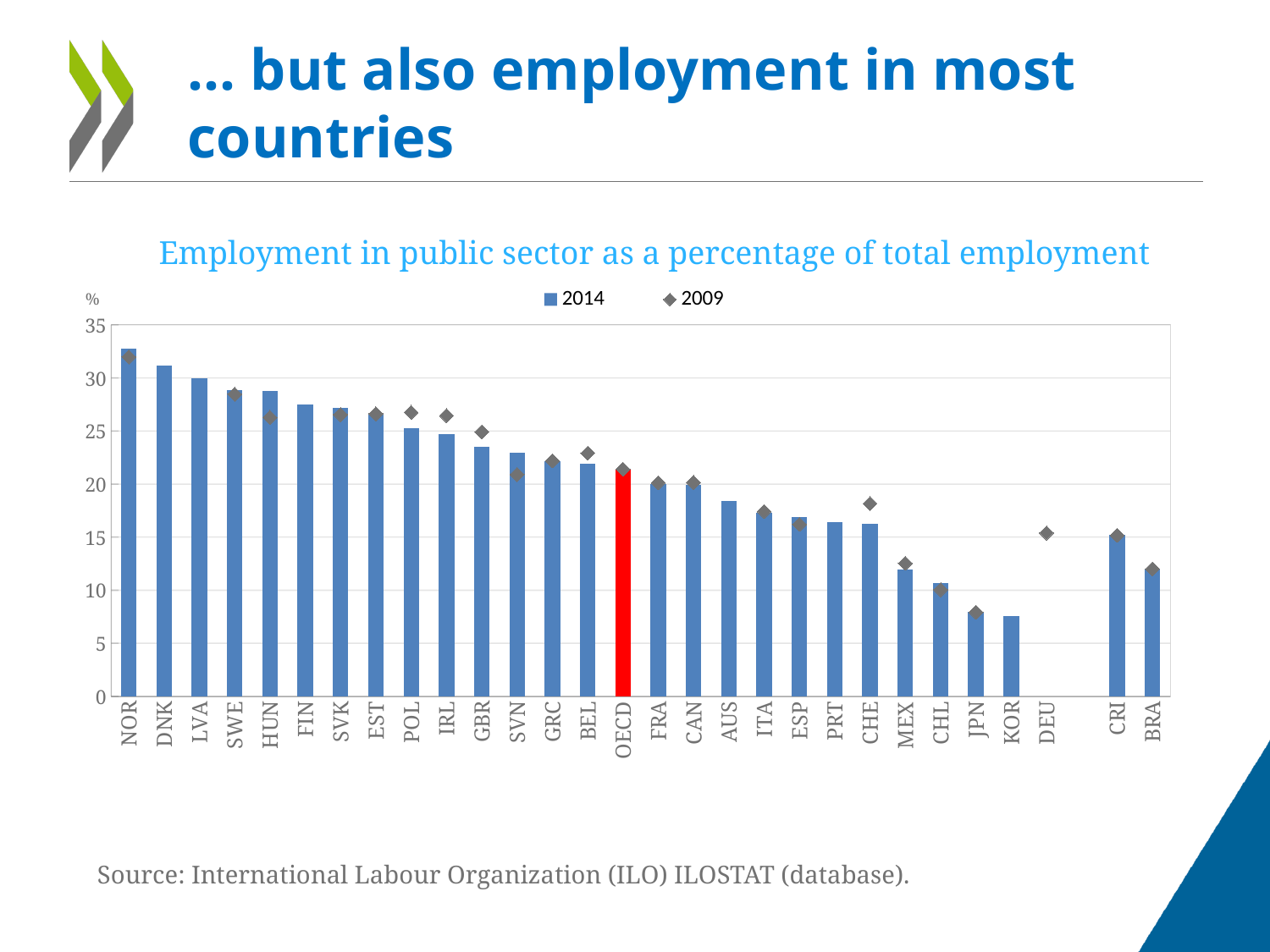
Do the 2014 bars generally rise or fall from left to right along the x axis? fall Which category has the shortest 2014 bar? KOR Is the 2014 value for OECD greater or less than 20? greater What kind of chart is shown on the slide? bar chart How many series does the legend list? 2 Which category has the tallest 2014 bar? NOR Is the 2014 value for AUS greater or less than 20? less Is the 2014 value for NOR greater or less than 30? greater Which has the larger 2014 value, MEX or CHL? MEX For CHE, which year has the larger value, 2014 or 2009? 2009 Which category's 2014 bar is coloured red? OECD